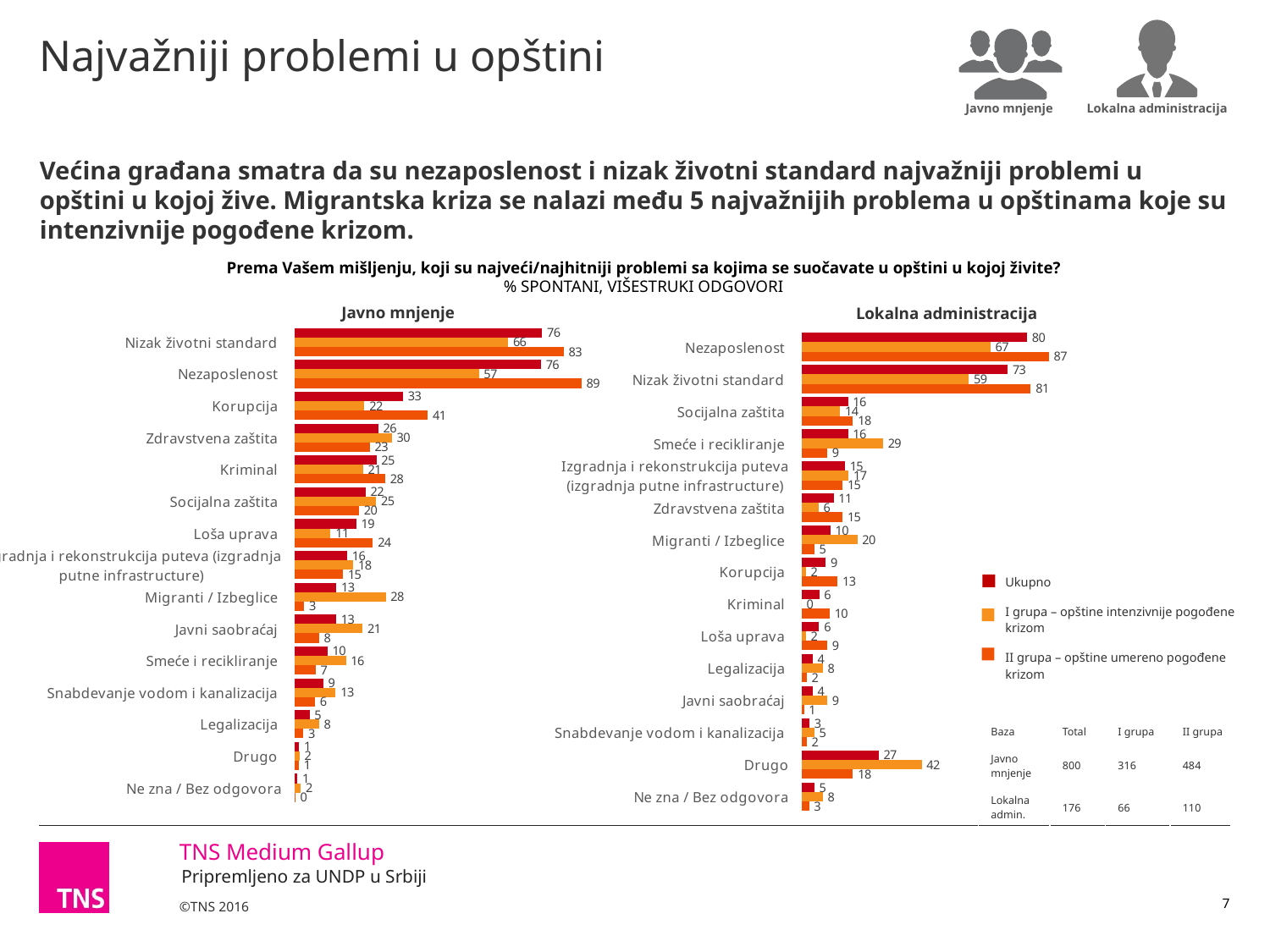
In the "Javno mnjenje" chart, which category has the lowest I grupa value? Drugo and Ne zna / Bez odgovora (both 2) In the "Lokalna administracija" chart, which category has the highest Ukupno value? Nezaposlenost In the "Javno mnjenje" chart, what is the Ukupno value for Korupcija? 33 In the "Javno mnjenje" chart, what is the difference between the II grupa and I grupa values for Nezaposlenost? 32 In the "Lokalna administracija" chart, what is the I grupa value for Smeće i recikliranje? 29 How many series does the legend list? 3 In the "Lokalna administracija" chart, what is the difference between the I grupa and II grupa values for Migranti / Izbeglice? 15 In the "Javno mnjenje" chart, which is larger for Migranti / Izbeglice: the I grupa value or the II grupa value? I grupa In the "Javno mnjenje" chart, what is the II grupa value for Nezaposlenost? 89 In the "Lokalna administracija" chart, what is the Ukupno value for Drugo? 27 How many categories are shown in the "Lokalna administracija" chart? 15 What type of chart is the "Javno mnjenje" chart? Bar chart